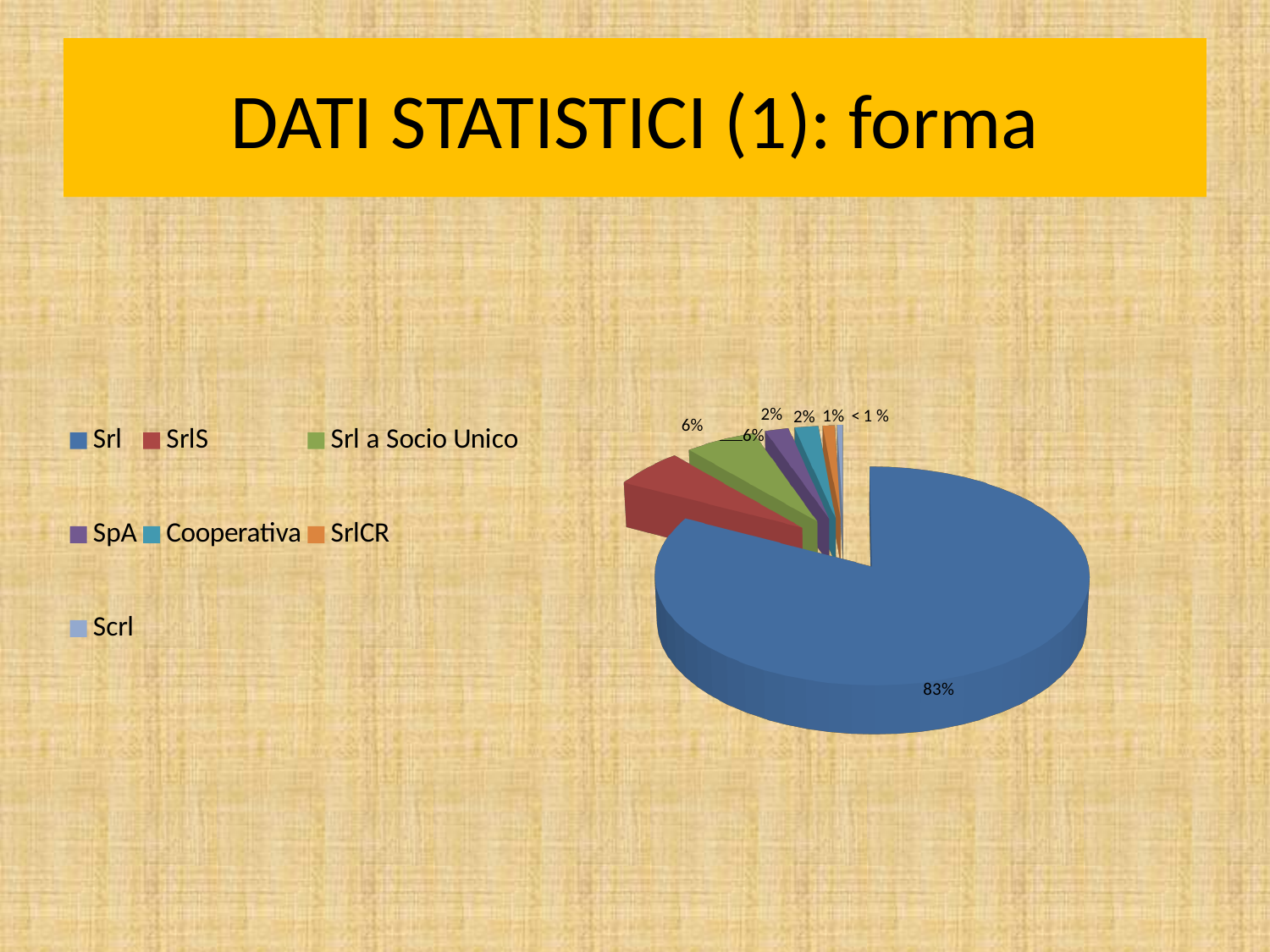
What share of the pie does SpA have? 2% What share of the pie does Srl have? 83% How many categories does the pie chart's legend list? 7 What share of the pie does SrlS have? 6% Which is larger, the share for Srl or the share for SrlS? Srl Which category has the smallest share of the pie? Scrl What share of the pie does SrlCR have? 1% What is the title of the slide containing the pie chart? DATI STATISTICI (1): forma What kind of chart is shown on the slide? pie chart What is the difference in percentage points between the Srl share and the SrlS share? 77 What label is shown for the Scrl slice? < 1 % Which category has the largest share of the pie? Srl